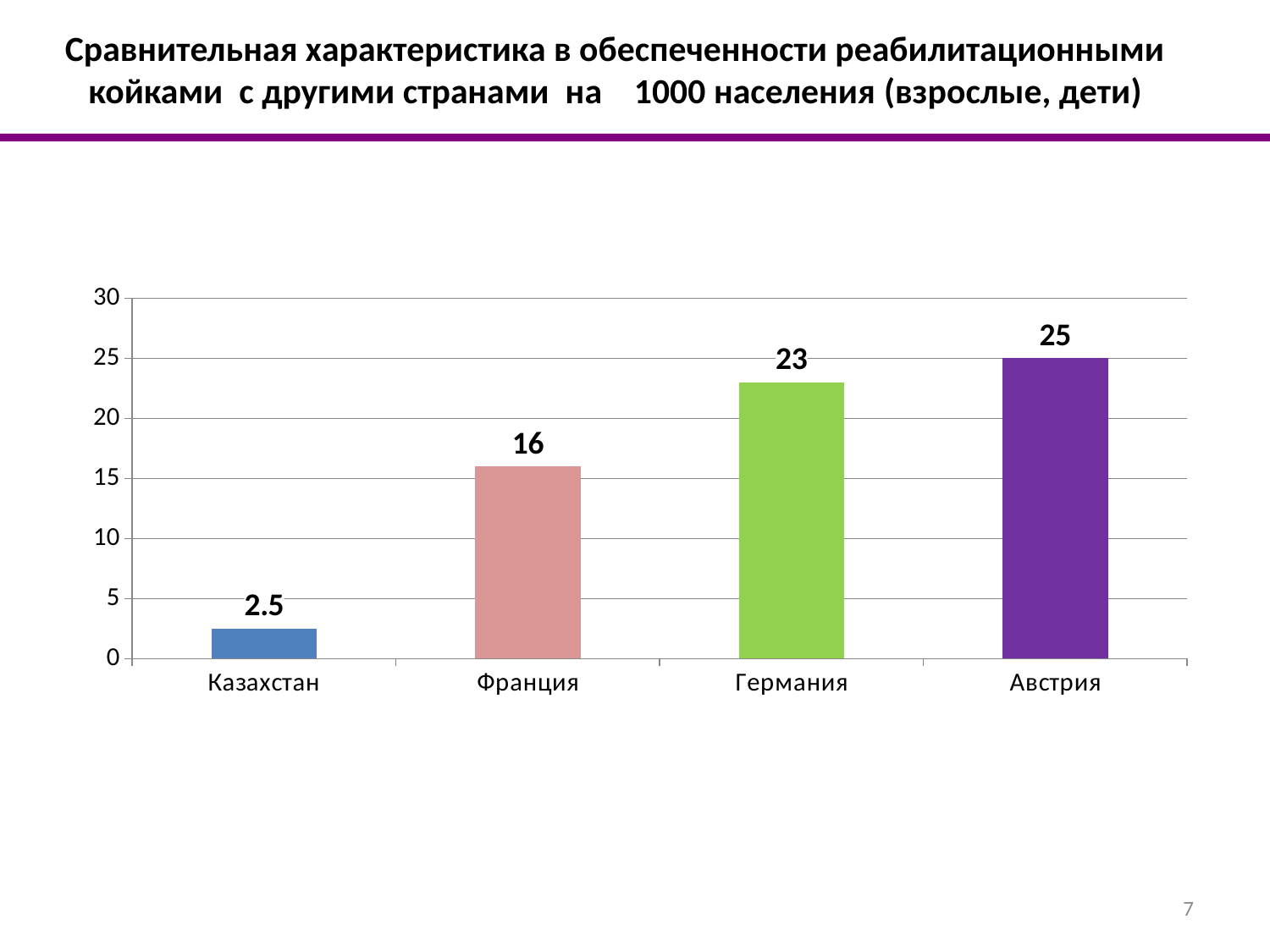
What is the value for Казахстан? 2.5 Which country has the highest value? Австрия What is the difference between the values for Германия and Франция? 7 Which is larger, the value for Франция or the value for Германия? Германия What is the difference between the values for Австрия and Казахстан? 22.5 What is the value for Австрия? 25 What is the value for Германия? 23 How many countries are shown on the chart? 4 Which country has the lowest value? Казахстан What kind of chart is shown on the slide? bar chart Do the values rise or fall from left to right along the x axis? rise What is the value for Франция? 16